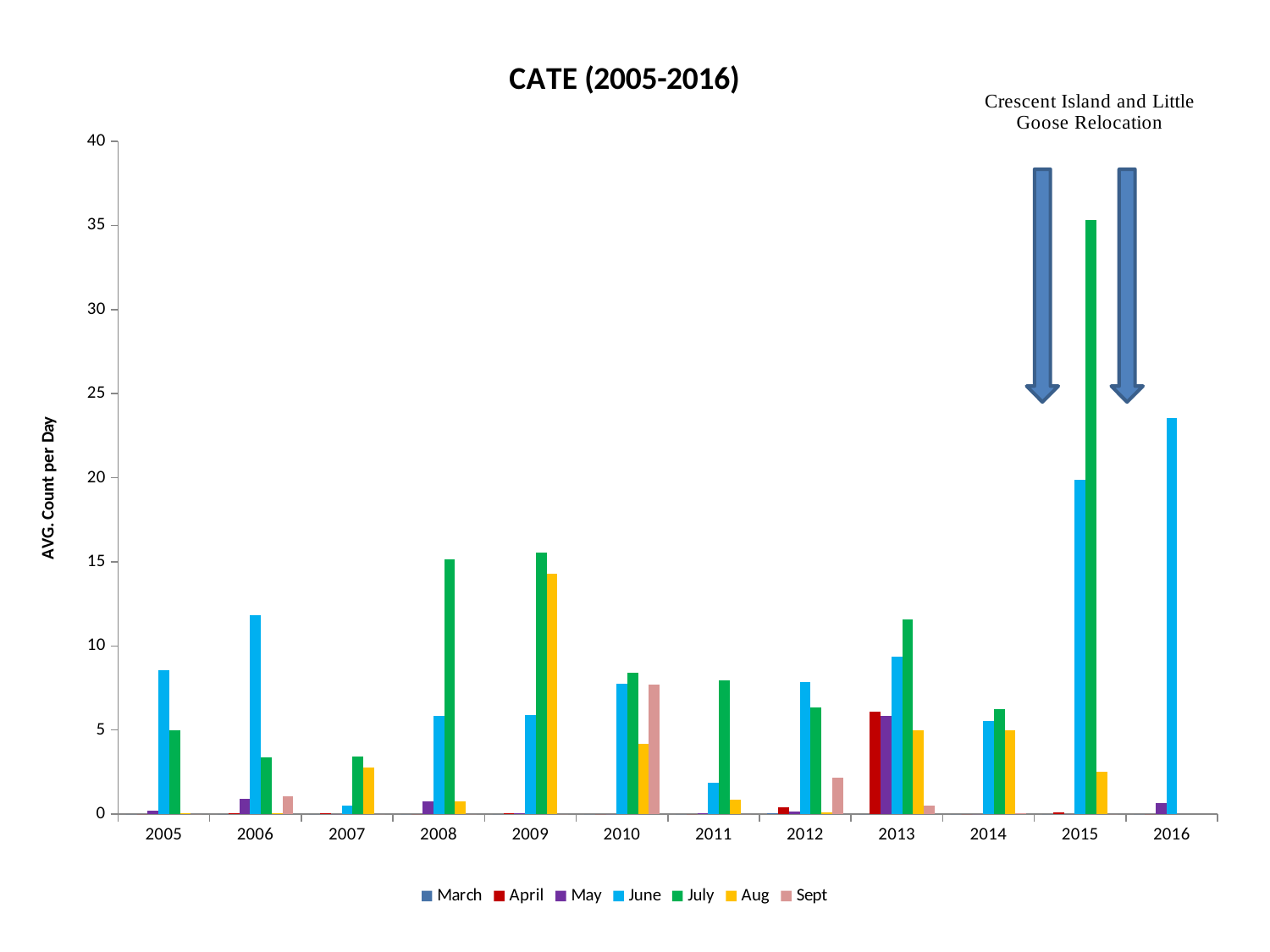
In 2008, which is larger, the June bar or the July bar? July How many years are shown along the x axis? 12 Is the value for June in 2006 greater or less than 10? greater How many series does the legend list? 7 What is the label on the y axis of the chart? AVG. Count per Day In 2012, which is larger, the June bar or the July bar? June In which year is the June bar the highest? 2016 In which year is the July bar the highest? 2015 What kind of chart is shown on the slide? bar chart Is the value for July in 2015 greater or less than 30? greater Is the value for Sept in 2010 greater or less than 5? greater